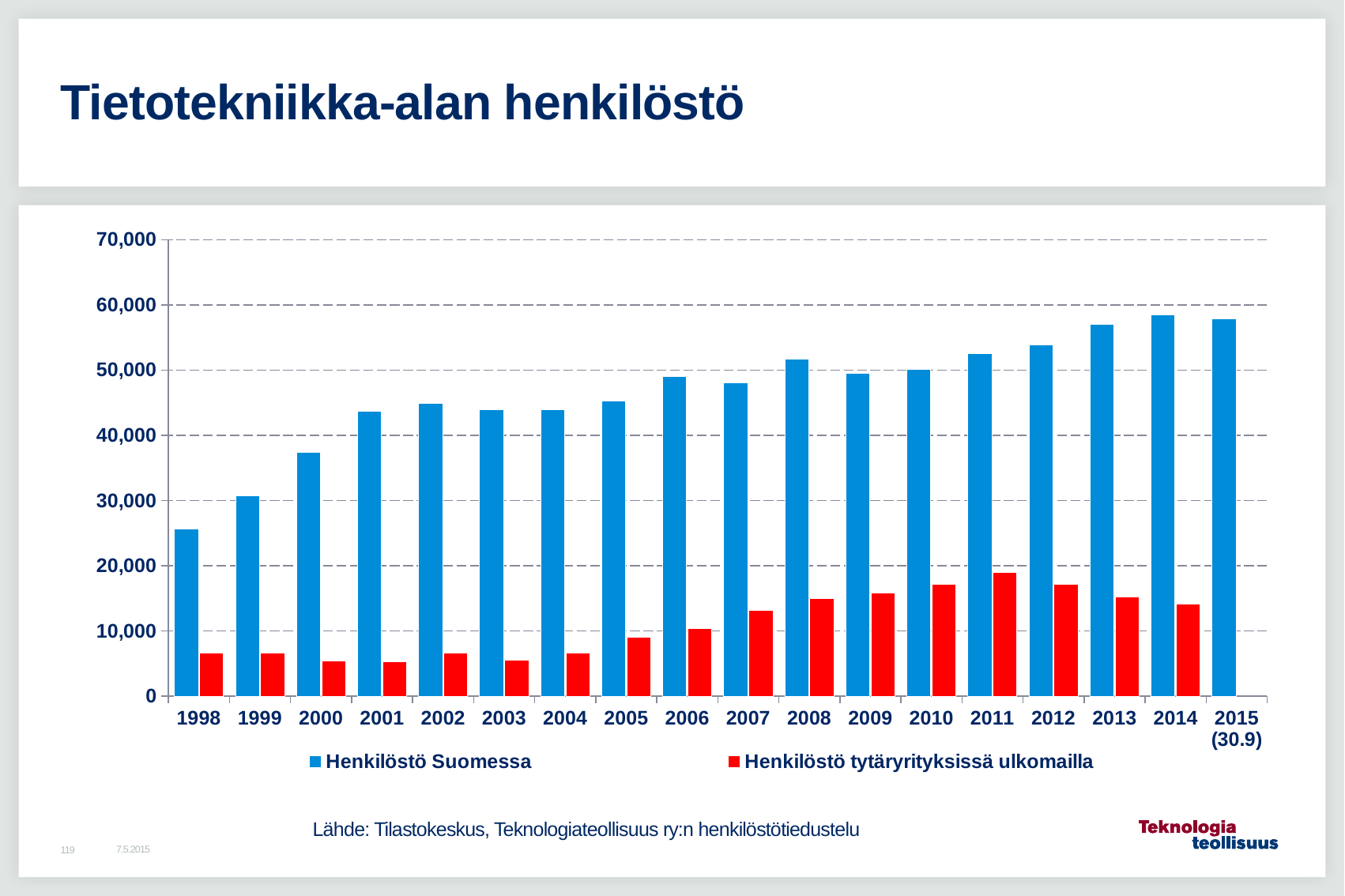
How many years (categories) are shown on the x axis? 18 What kind of chart is shown on the slide? bar chart Which year has the highest value for Henkilöstö tytäryrityksissä ulkomailla? 2011 Does Henkilöstö Suomessa generally rise or fall from 1998 to 2014? rise Is the value for Henkilöstö tytäryrityksissä ulkomailla in 2007 greater or less than 10,000? greater Which year has the lowest value for Henkilöstö Suomessa? 1998 Is the value for Henkilöstö Suomessa in 1998 greater or less than 20,000? greater How many series does the legend list? 2 Is the value for Henkilöstö Suomessa in 2000 greater or less than 40,000? less Which is larger for Henkilöstö tytäryrityksissä ulkomailla: 2012 or 2013? 2012